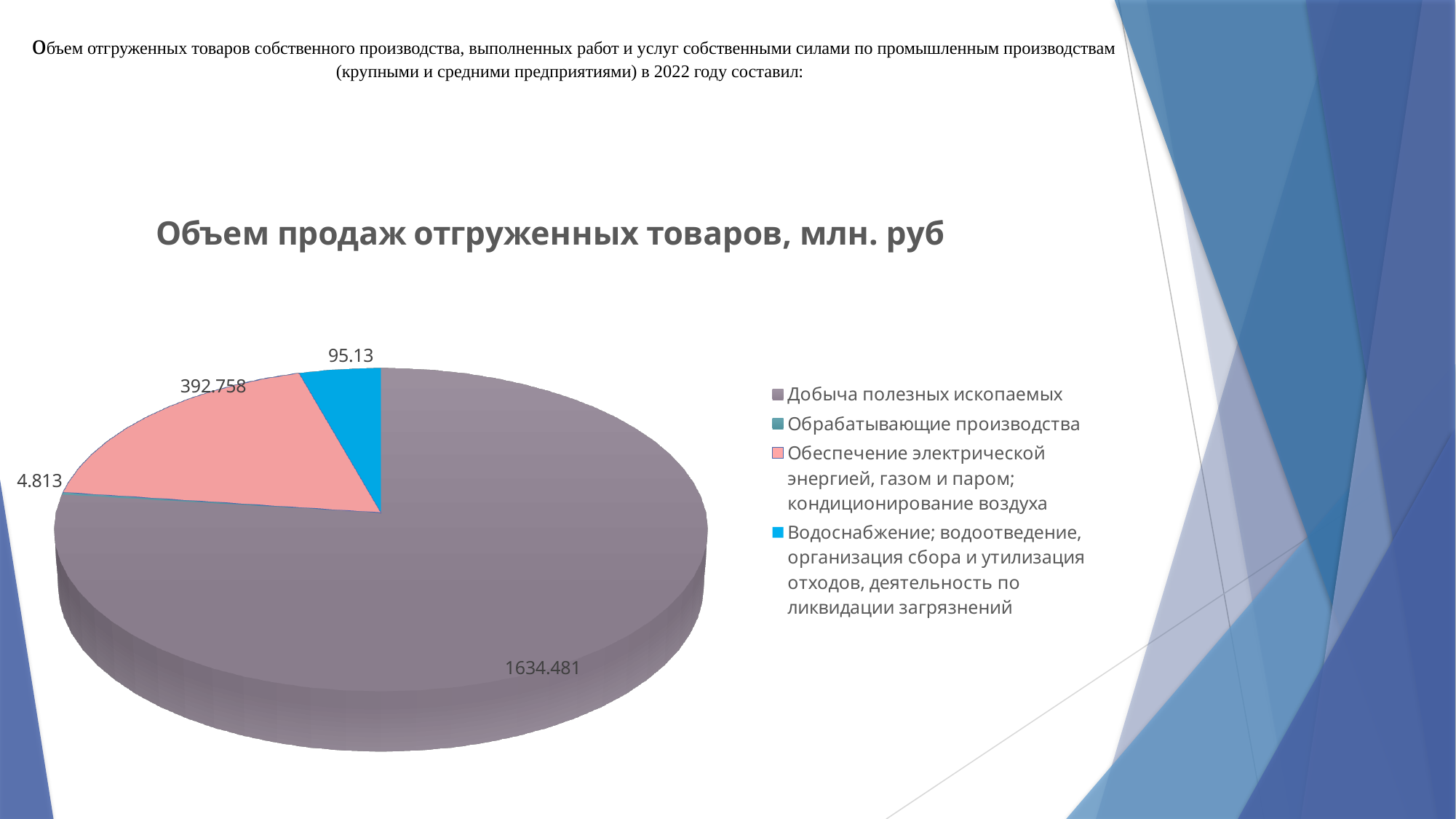
Which category has the largest slice of the pie? Добыча полезных ископаемых What is the title of the chart? Объем продаж отгруженных товаров, млн. руб What is the value for Водоснабжение; водоотведение, организация сбора и утилизация отходов, деятельность по ликвидации загрязнений? 95.13 Which category has the smallest slice of the pie? Обрабатывающие производства What is the value for Обрабатывающие производства? 4.813 What is the value for Обеспечение электрической энергией, газом и паром; кондиционирование воздуха? 392.758 Which is larger: the value for Обеспечение электрической энергией, газом и паром; кондиционирование воздуха or the value for Водоснабжение; водоотведение, организация сбора и утилизация отходов, деятельность по ликвидации загрязнений? Обеспечение электрической энергией, газом и паром; кондиционирование воздуха What is the value for Добыча полезных ископаемых? 1634.481 How many categories does the legend of the pie chart list? 4 What is the difference between the values for Добыча полезных ископаемых and Обеспечение электрической энергией, газом и паром; кондиционирование воздуха? 1241.723 What is the total of all four values shown on the pie chart? 2127.182 What type of chart is shown on the slide? Pie chart